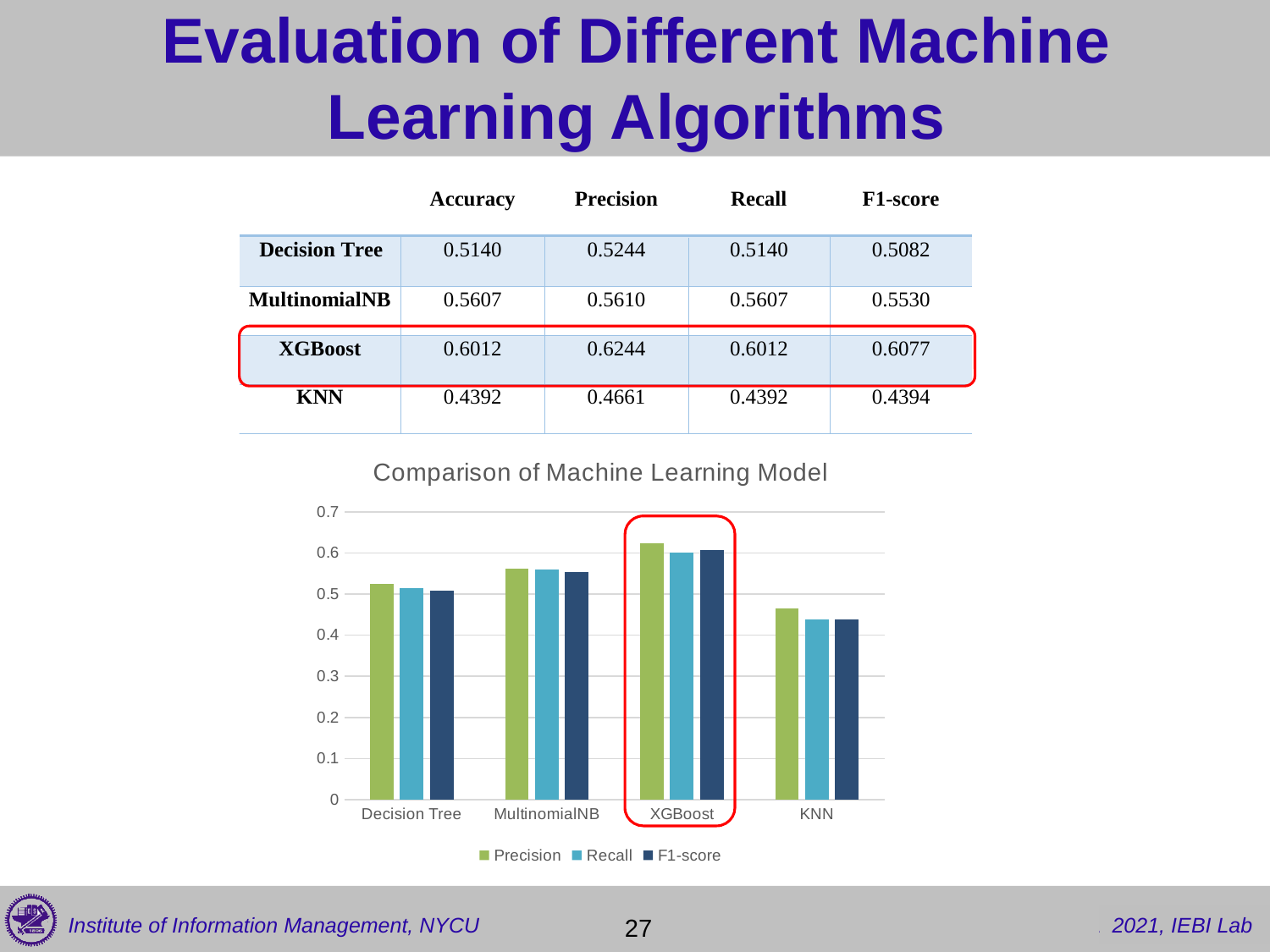
Which model's bars are highlighted with a red rounded box in the chart? XGBoost In the chart, which model has the lowest Recall bar? KNN According to the table on the slide, what is the F1-score of KNN? 0.4394 How many machine learning models are shown on the x axis of the chart? 4 In the chart, is the Precision value for XGBoost greater or less than 0.6? greater In the chart, which has the larger Precision bar: Decision Tree or MultinomialNB? MultinomialNB In the chart, which model has the highest Precision bar? XGBoost Using the values in the table, what is the difference between the Precision of XGBoost and the Precision of KNN? 0.1583 What kind of chart is shown under the title "Comparison of Machine Learning Model"? bar chart In the chart, is the Recall value for KNN greater or less than 0.5? less How many series does the legend of the "Comparison of Machine Learning Model" chart list? 3 According to the table on the slide, what is the Precision of XGBoost? 0.6244